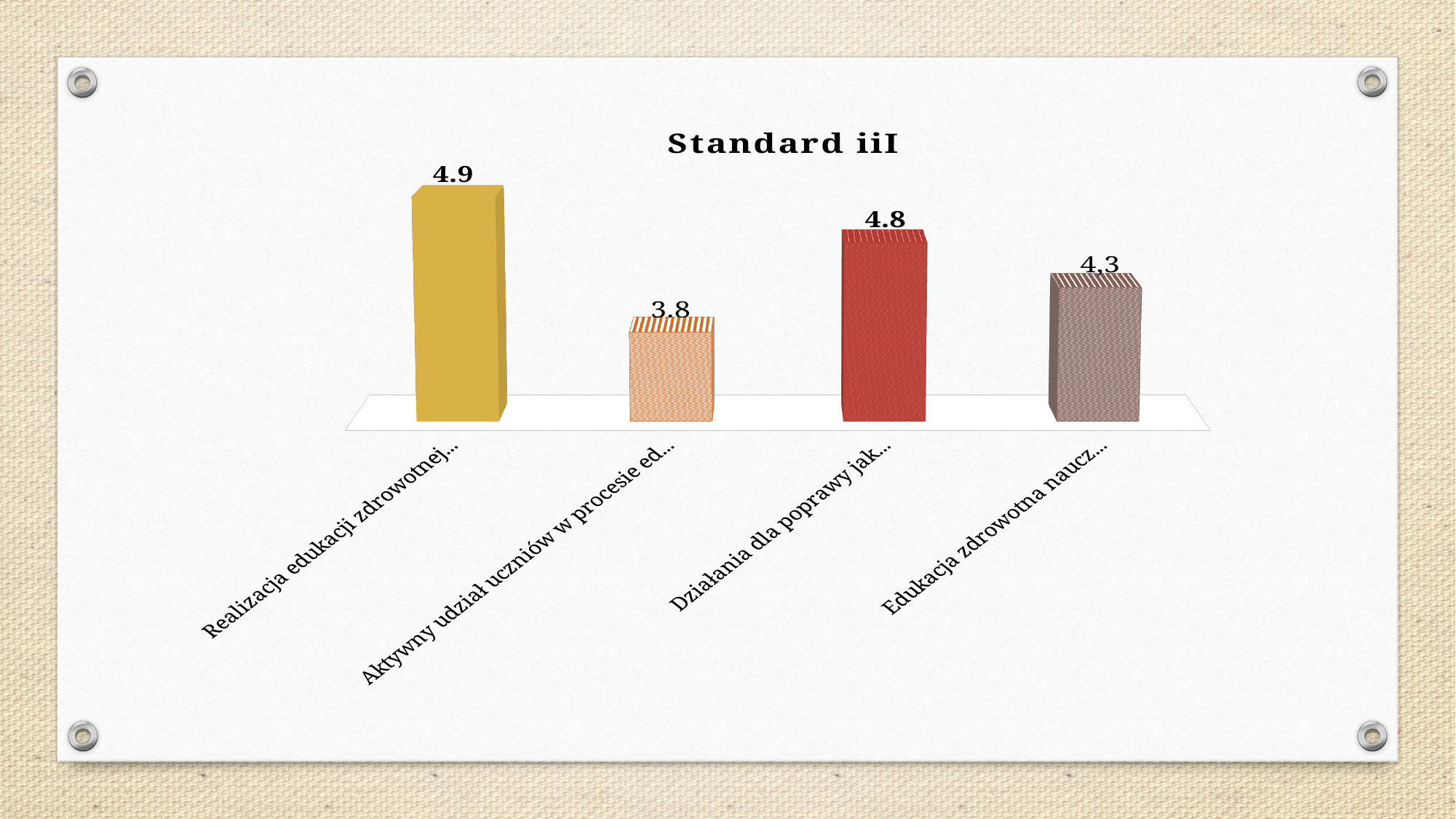
What kind of chart is shown on the slide? Bar chart Which is larger, the value for "Działania dla poprawy jak..." or the value for "Edukacja zdrowotna naucz..."? Działania dla poprawy jak... What is the difference between the values for "Realizacja edukacji zdrowotnej..." and "Aktywny udział uczniów w procesie ed..."? 1.1 What is the title of the chart? Standard iiI What colour is the first (leftmost) bar? Yellow How many bars are shown in the chart? 4 What value is shown for the bar labelled "Działania dla poprawy jak..."? 4.8 What value is shown for the bar labelled "Aktywny udział uczniów w procesie ed..."? 3.8 What value is shown for the bar labelled "Edukacja zdrowotna naucz..."? 4,3 Which category has the lowest value? Aktywny udział uczniów w procesie ed... What value is shown for the bar labelled "Realizacja edukacji zdrowotnej..."? 4.9 Which category has the highest value? Realizacja edukacji zdrowotnej...